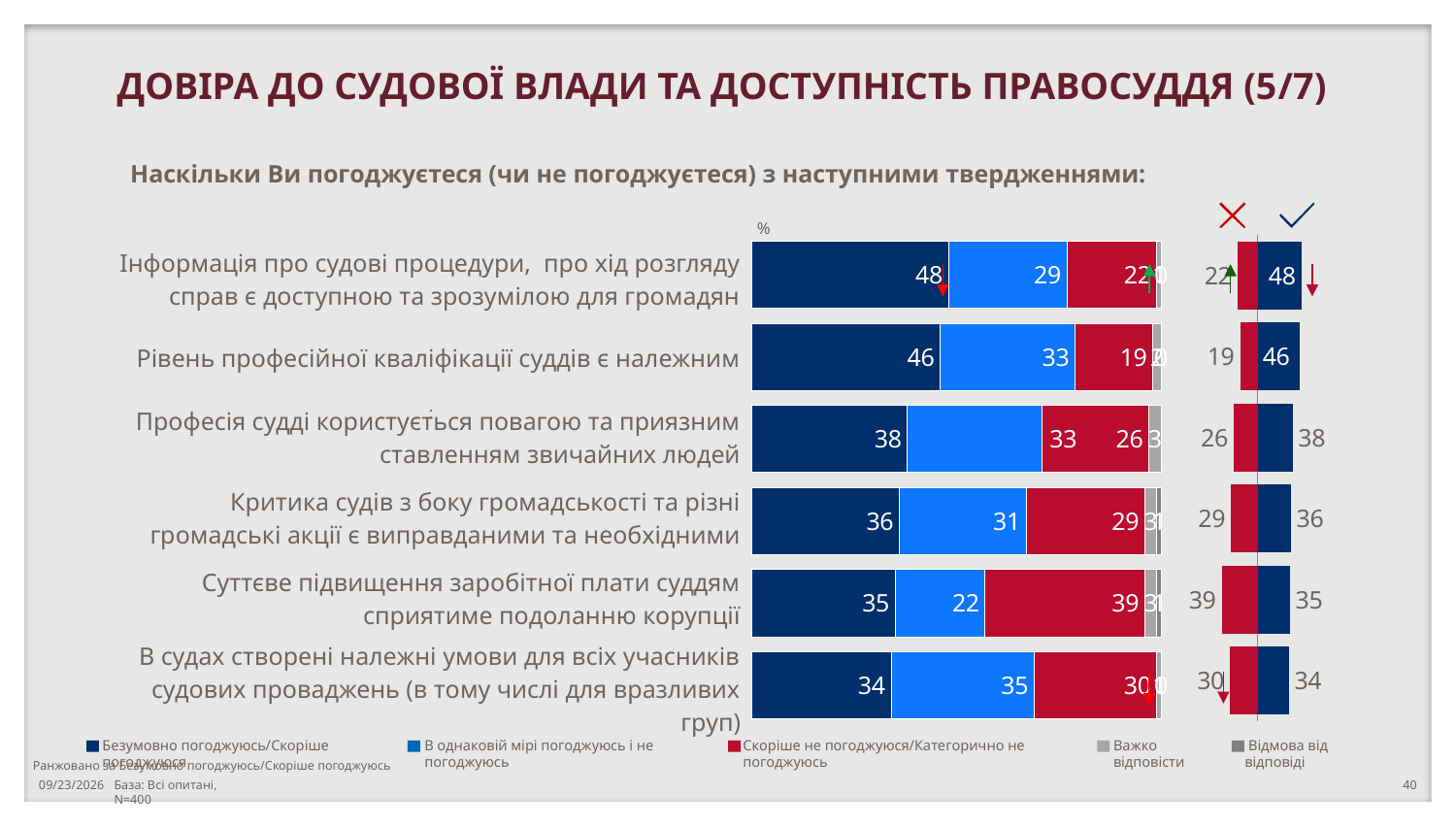
What is the difference between the agreement share for the statement about information on court procedures (48) and the statement about judges' qualification (46)? 2 What percentage strongly/rather agree that the level of professional qualification of judges is adequate? 46 For the statement about criticism of courts by the public, which is larger: the share who agree or the share who disagree? Agree (36) How many statements are shown in the chart? 6 What type of chart is used on the slide? Stacked bar chart Which statement has the highest share of rather/categorical disagreement? Суттєве підвищення заробітної плати суддям сприятиме подоланню корупції Which statement has the lowest share of strong/rather agreement? В судах створені належні умови для всіх учасників судових проваджень (в тому числі для вразливих груп) How many series does the legend list? 5 Which statement has the highest share of strong/rather agreement? Інформація про судові процедури, про хід розгляду справ є доступною та зрозумілою для громадян What percentage strongly/rather agree that information about court procedures is accessible and understandable for citizens? 48 What percentage equally agree and disagree that courts have created proper conditions for all participants in court proceedings? 35 What percentage rather/categorically disagree that a substantial increase in judges' salaries will help overcome corruption? 39